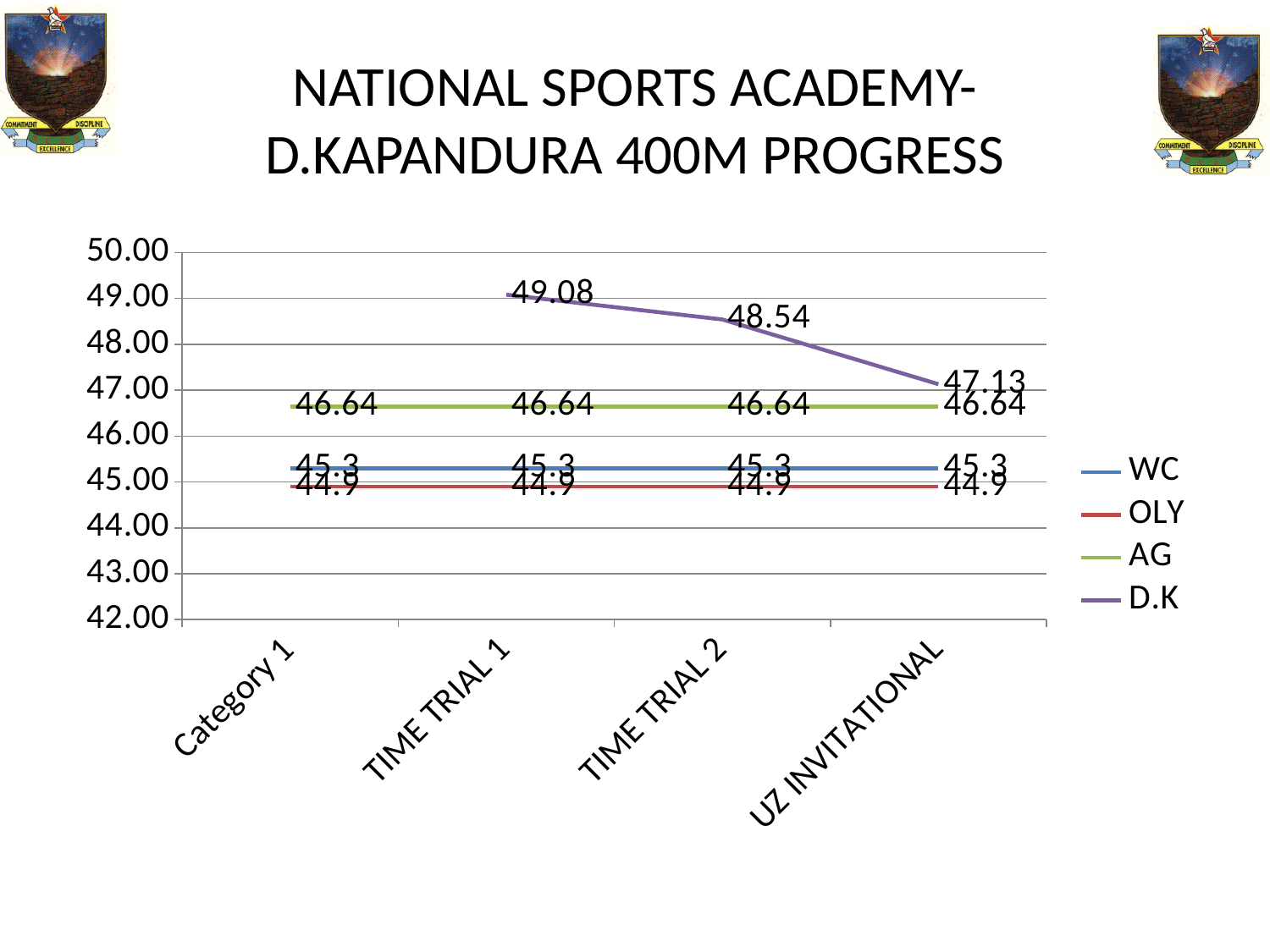
What is the value for WC at UZ INVITATIONAL? 45.3 What is the value for D.K at TIME TRIAL 1? 49.08 What is the value for AG at TIME TRIAL 2? 46.64 What is the difference between the D.K values at TIME TRIAL 1 and TIME TRIAL 2? 0.54 What is the value for OLY at Category 1? 44.9 Which series has the lowest value at TIME TRIAL 1? OLY What kind of chart is shown on the slide? line chart What is the value for D.K at UZ INVITATIONAL? 47.13 Does the D.K series rise or fall from TIME TRIAL 1 to UZ INVITATIONAL? fall How many series does the legend list? 4 Which series has the highest value at UZ INVITATIONAL? D.K What is the value for D.K at TIME TRIAL 2? 48.54